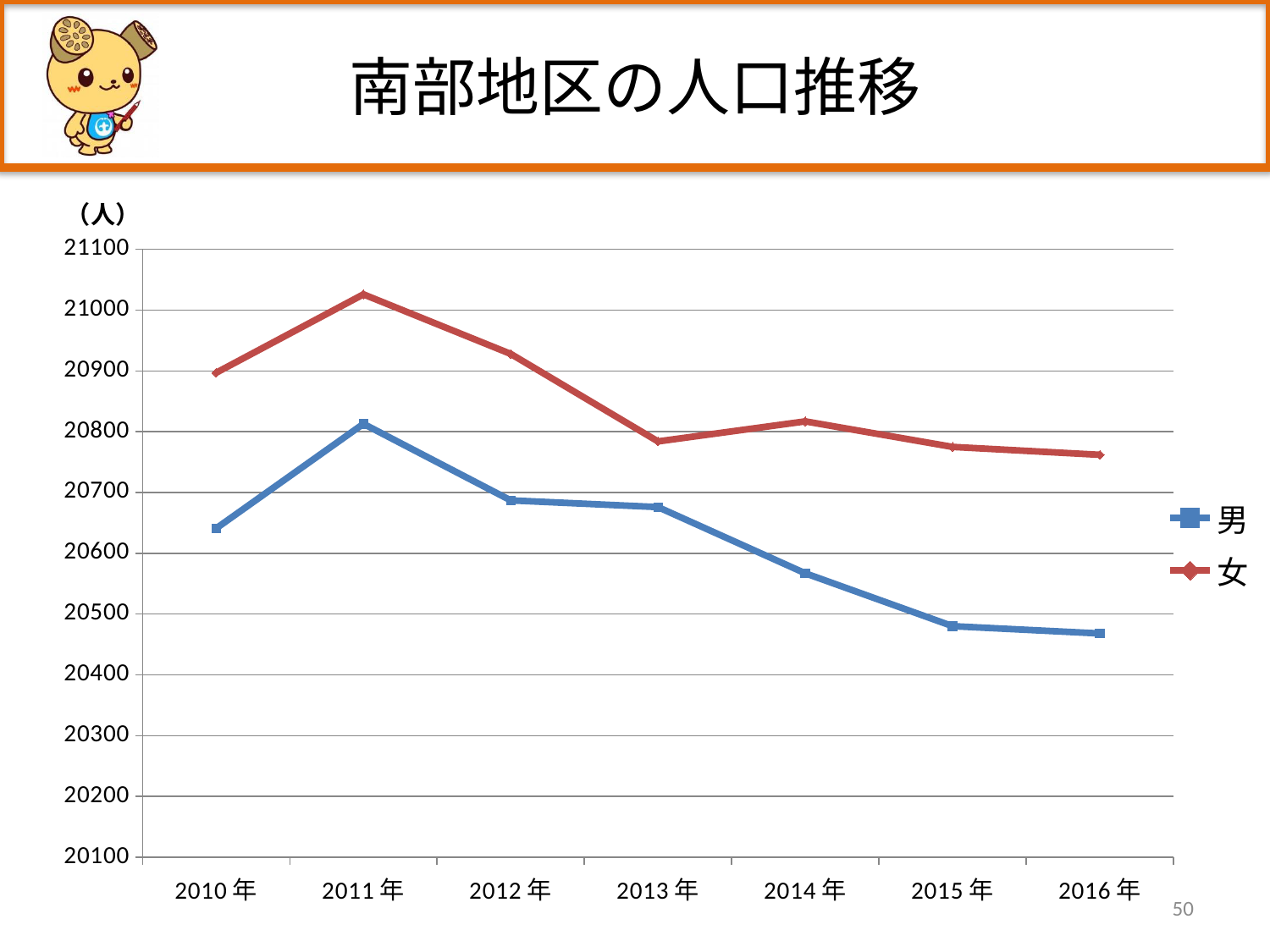
Is the value for 女 in 2012年 greater or less than 20900? greater What kind of chart is shown on the slide? line chart How many series does the legend list? 2 Is the value for 女 in 2011年 greater or less than 21000? greater Does the 男 series rise or fall from 2011年 to 2016年? fall Is the value for 男 in 2010年 greater or less than 20600? greater Which series has the larger value in 2013年, 男 or 女? 女 In which year does the 男 series reach its highest value? 2011年 How many years are plotted along the x axis? 7 In which year does the 女 series reach its highest value? 2011年 What is the title of the chart? 南部地区の人口推移